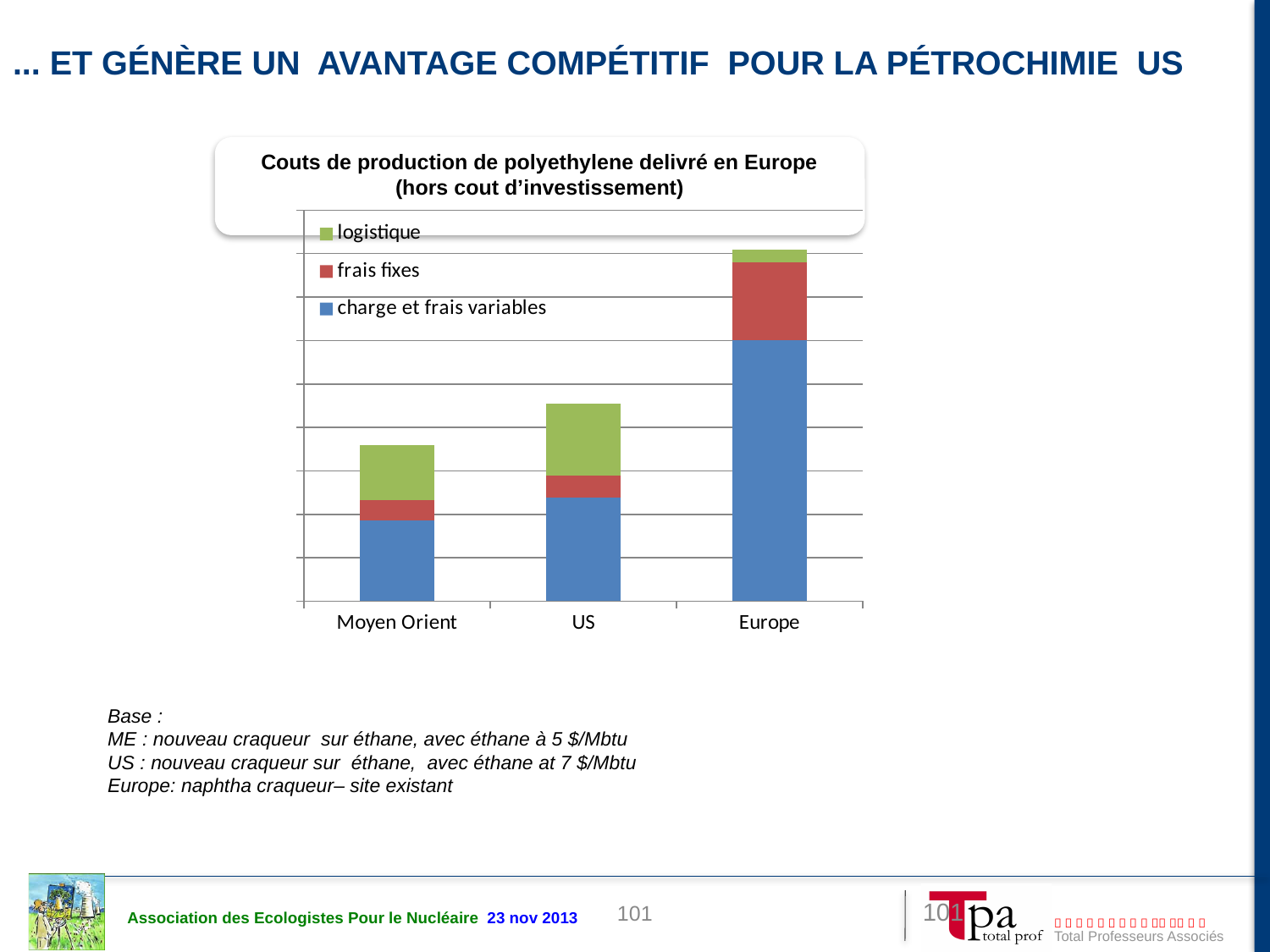
Which category has the smallest 'logistique' segment? Europe How many series does the chart's legend list? 3 Which category has the largest 'frais fixes' segment? Europe What is the title of the chart? Couts de production de polyethylene delivré en Europe (hors cout d'investissement) Which has a larger total bar, Moyen Orient or US? US What kind of chart is shown on the slide? stacked bar chart How many categories are shown on the x axis of the chart? 3 Which category has the largest 'charge et frais variables' segment? Europe Do the total bar heights rise or fall from Moyen Orient to Europe along the x axis? rise Which category has the highest total production cost in the chart? Europe Which has a larger total bar, US or Europe? Europe Which category has the lowest total production cost in the chart? Moyen Orient